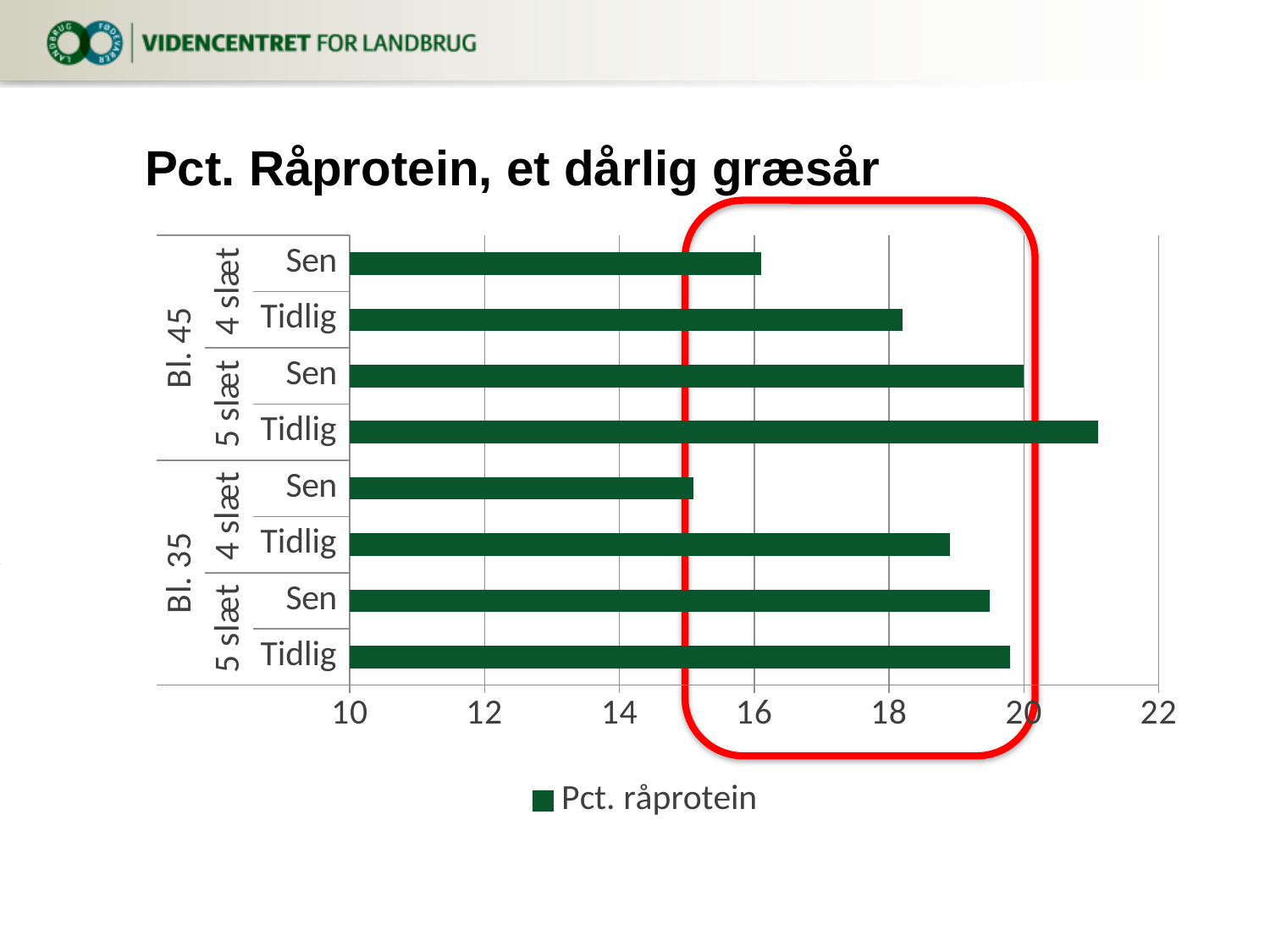
Within Bl. 45, 4 slæt, which is larger: Sen or Tidlig? Tidlig How many bars are plotted in the chart? 8 Which bar has the highest value? Bl. 45, 5 slæt, Tidlig Is the value for Bl. 35, 5 slæt, Sen greater or less than 20? less What kind of chart is shown on the slide? Bar chart What is the legend entry for the plotted series? Pct. råprotein How many series does the legend list? 1 What is the title of the chart? Pct. Råprotein, et dårlig græsår Is the value for Bl. 35, 4 slæt, Sen greater or less than 16? less Which bar has the lowest value? Bl. 35, 4 slæt, Sen Is the value for Bl. 45, 5 slæt, Tidlig greater or less than 20? greater Which is larger: Bl. 45, 5 slæt, Tidlig or Bl. 35, 5 slæt, Tidlig? Bl. 45, 5 slæt, Tidlig